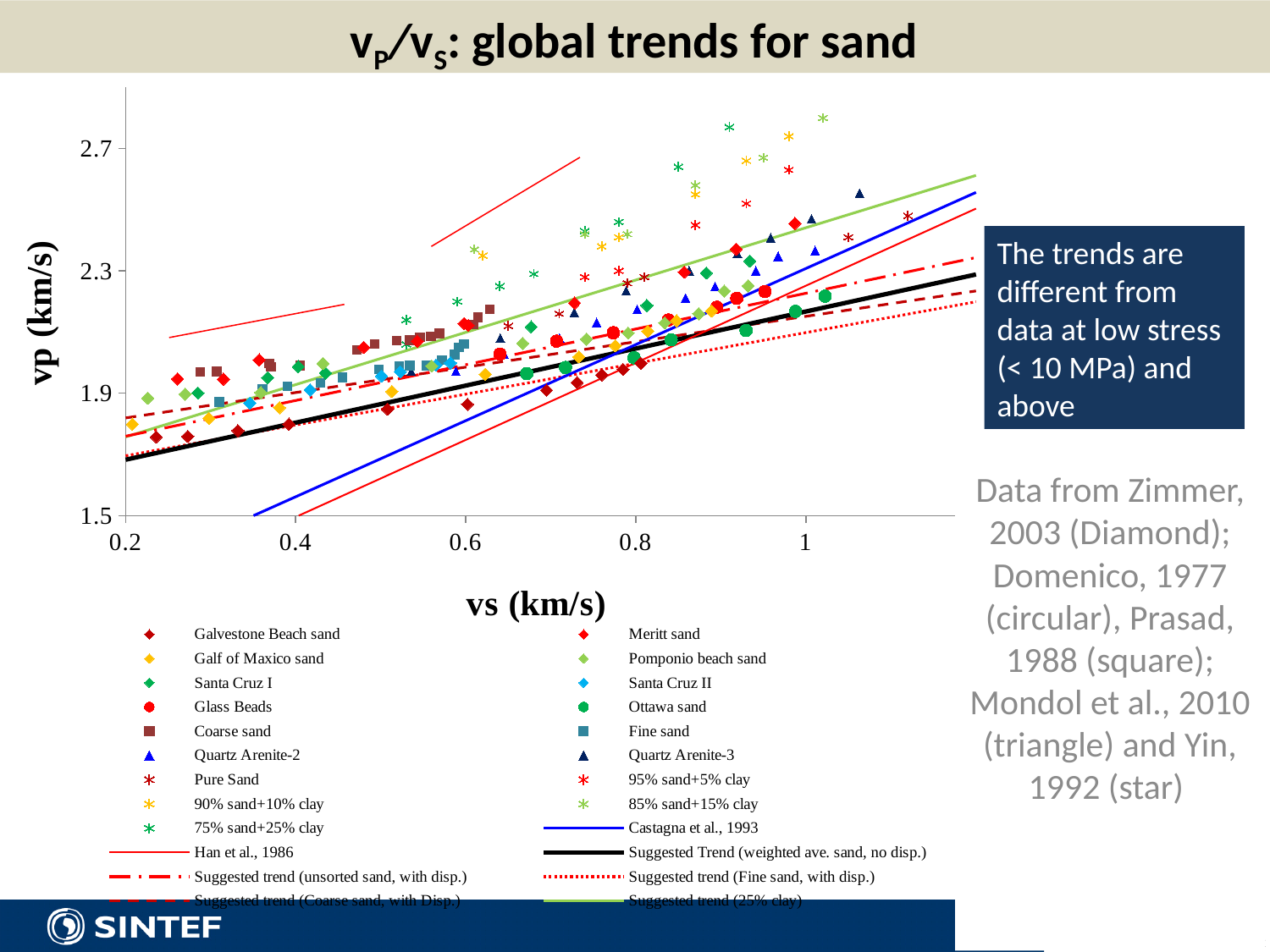
Is the vp value of the Suggested Trend (weighted ave. sand, no disp.) line at vs = 0.2 greater or less than 1.9? less Is the vp value of the highest plotted point greater or less than 2.7? greater What quantity is plotted on the vertical axis of the chart? vp (km/s) Do the plotted vp values generally rise or fall as vs increases along the x axis? rise What is the title of the chart on the slide? vP/vS: global trends for sand Is the vp value of the Suggested trend (25% clay) line at vs = 1 greater or less than 2.3? greater What is the highest value shown on the vertical axis of the chart? 2.7 What kind of chart is shown on the slide? scatter chart What is the lowest value shown on the vertical axis of the chart? 1.5 At vs = 1, which line is higher: Suggested trend (25% clay) or Suggested Trend (weighted ave. sand, no disp.)? Suggested trend (25% clay) How many entries does the chart legend list? 24